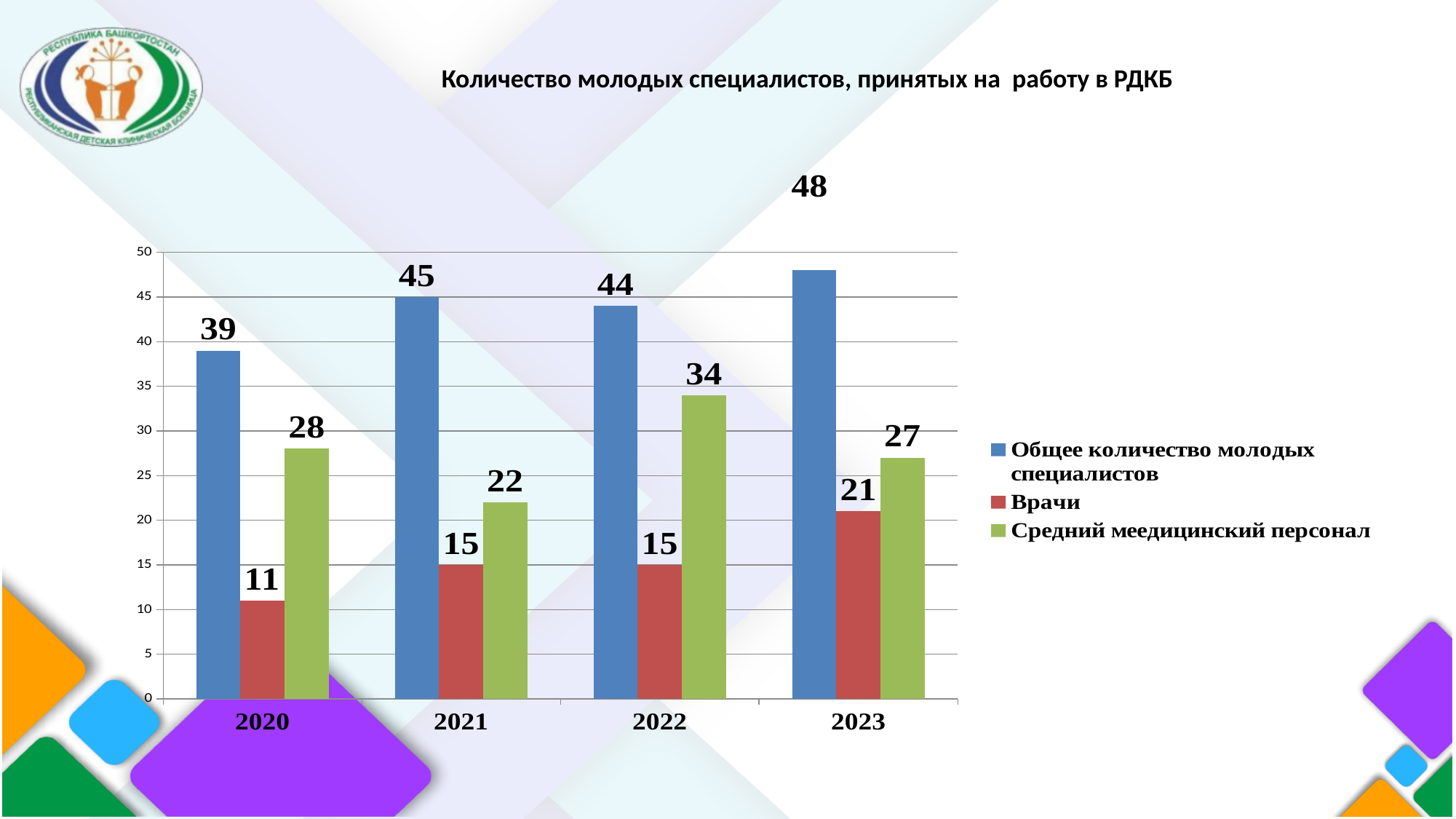
Which is larger: the value for Средний медицинский персонал in 2020 or in 2021? 2020 What kind of chart is shown on the slide? Bar chart Which colour represents Врачи in the legend? Red How many doctors (Врачи) were hired in 2020? 11 Did the number of doctors (Врачи) rise or fall from 2022 to 2023? Rise How many years are shown on the x axis? 4 In which year was the total number of young specialists the highest? 2023 What was the total number of young specialists (Общее количество молодых специалистов) in 2023? 48 How many series does the legend list? 3 In which year was the number of doctors (Врачи) the lowest? 2020 What is the difference between the total number of young specialists in 2023 and in 2020? 9 What is the value for Средний медицинский персонал in 2022? 34